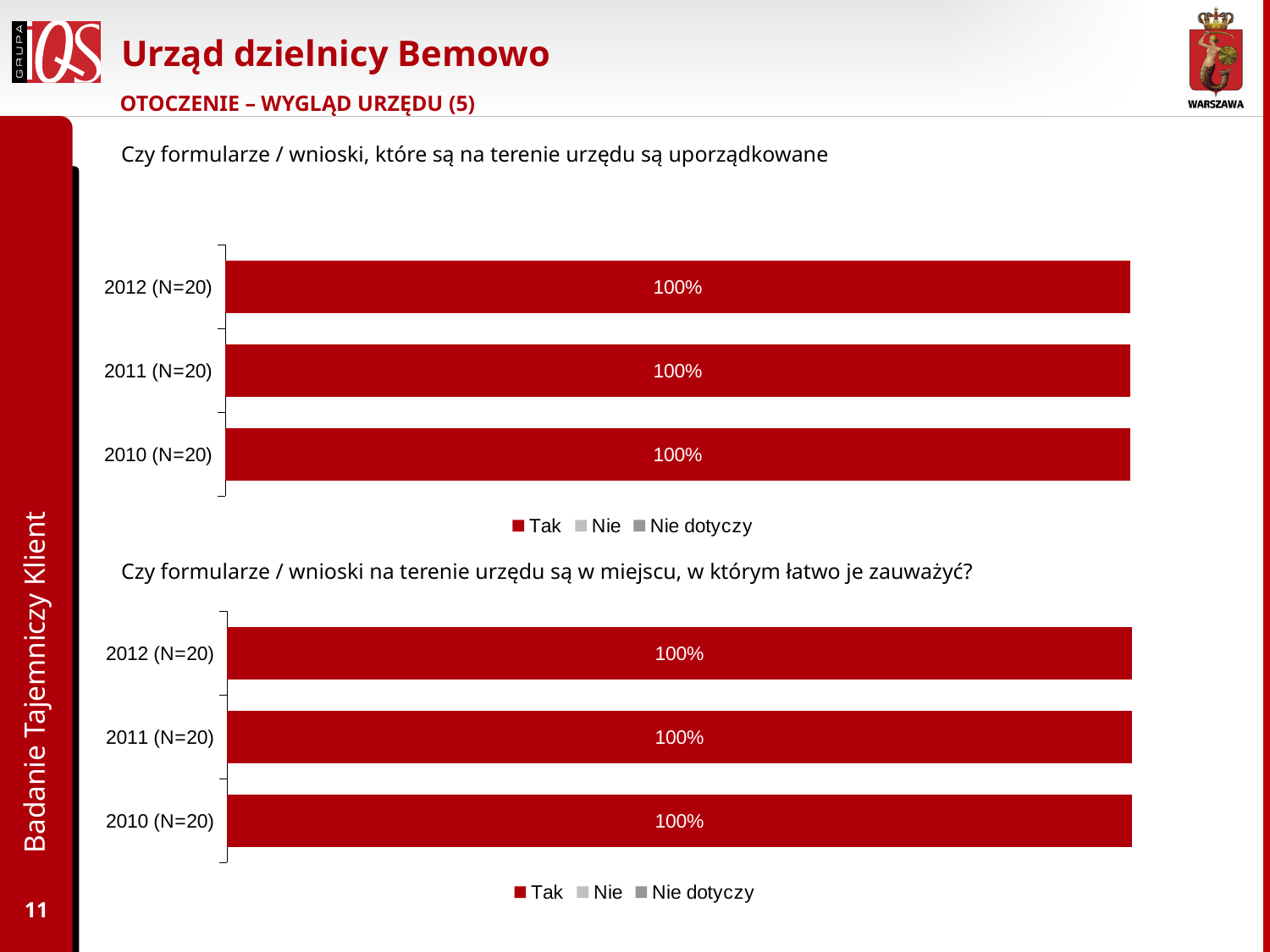
How many year categories are shown in the top chart? 3 What are the three legend entries in the bottom chart? Tak, Nie, Nie dotyczy In the bottom chart, what is the value for Tak in 2012 (N=20)? 100% In the top chart, what is the difference between the Tak value for 2012 (N=20) and 2010 (N=20)? 0% In the top chart ("Czy formularze / wnioski, które są na terenie urzędu są uporządkowane"), what is the value for Tak in 2012 (N=20)? 100% In the bottom chart, is the Tak value for 2010 (N=20) greater or less than 50%? greater What type of chart is the bottom chart? Bar chart How many series does the legend of the top chart list? 3 In the top chart, what is the value for Tak in 2010 (N=20)? 100% How many year categories are shown in the bottom chart? 3 In the top chart, what is the sample size (N) shown for 2011? N=20 In the bottom chart ("Czy formularze / wnioski na terenie urzędu są w miejscu, w którym łatwo je zauważyć?"), what is the value for Tak in 2011 (N=20)? 100%